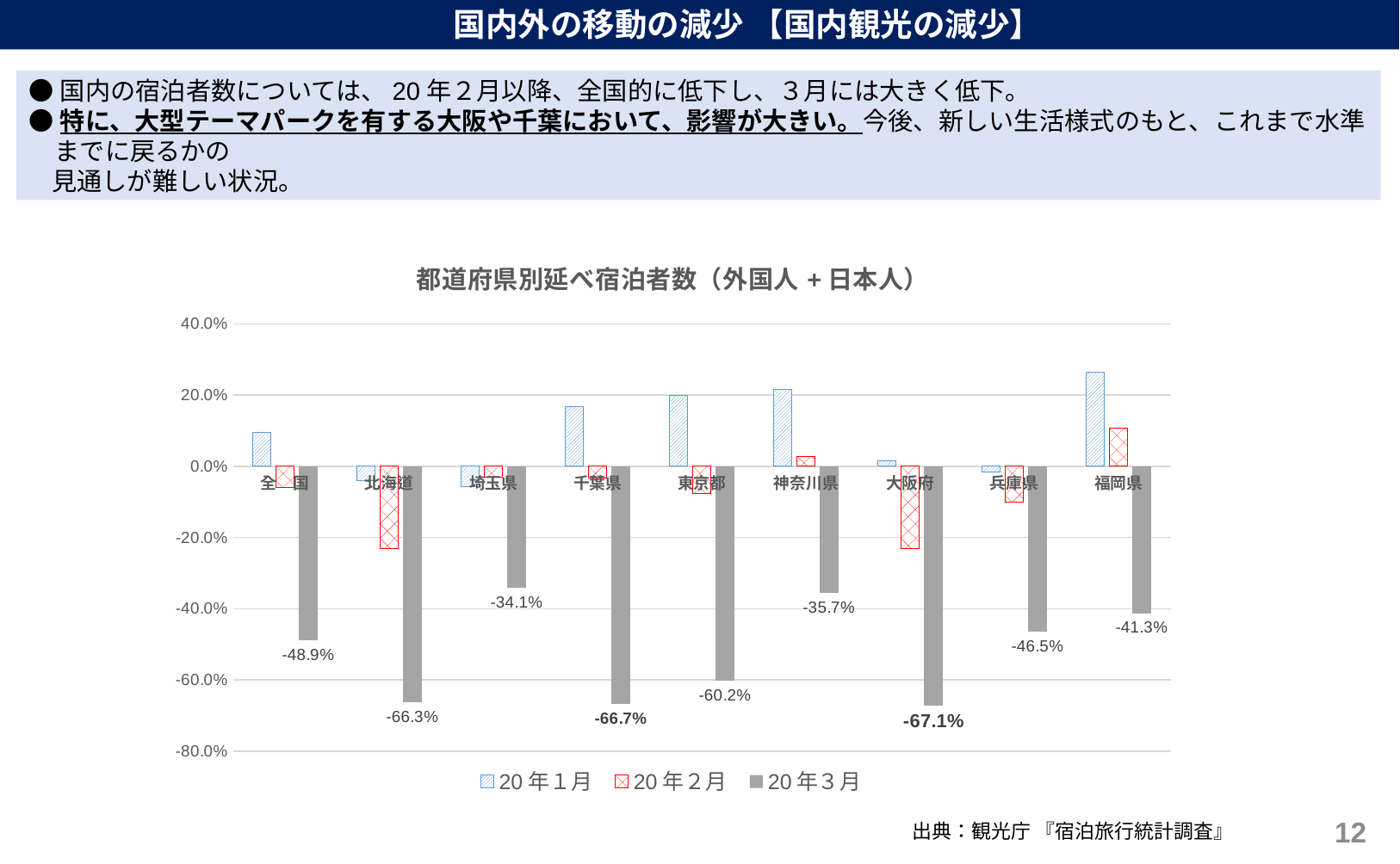
Is the 20年2月 value for 北海道 greater or less than -20.0%? less Which is larger, the 20年3月 value for 東京都 or for 北海道? 東京都 What is the difference between the 20年3月 values for 大阪府 and 全国? 18.2 percentage points How many series does the legend list? 3 Which category has the highest (least negative) 20年3月 value? 埼玉県 What is the 20年3月 value for 全国? -48.9% Is the 20年1月 value for 福岡県 greater or less than 20.0%? greater Which prefecture has the lowest 20年3月 value? 大阪府 What is the 20年3月 value for 埼玉県? -34.1% What type of chart is shown? Bar chart How many categories are shown on the x axis? 9 What is the 20年3月 value for 大阪府? -67.1%